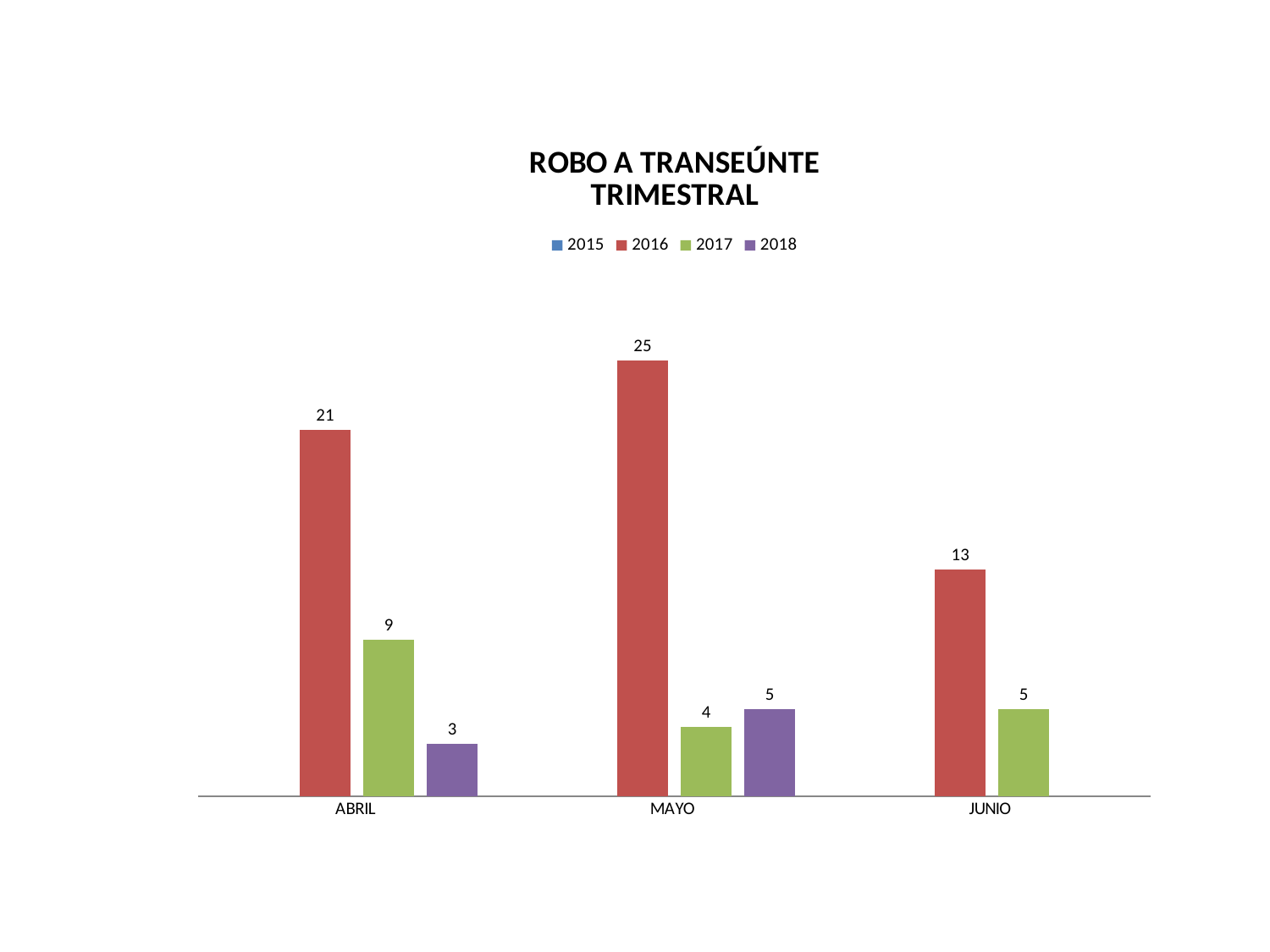
What is the value for 2018 in ABRIL? 3 In which month is the 2017 value lowest? MAYO How many months are shown on the x axis? 3 How many series does the legend list? 4 What is the value for 2017 in ABRIL? 9 In which month is the 2016 value highest? MAYO What is the value for 2016 in MAYO? 25 What kind of chart is shown? bar chart What is the difference between the 2016 values for MAYO and JUNIO? 12 What is the title of the chart? ROBO A TRANSEÚNTE TRIMESTRAL Which is larger in MAYO, the 2017 value or the 2018 value? 2018 What is the value for 2016 in JUNIO? 13